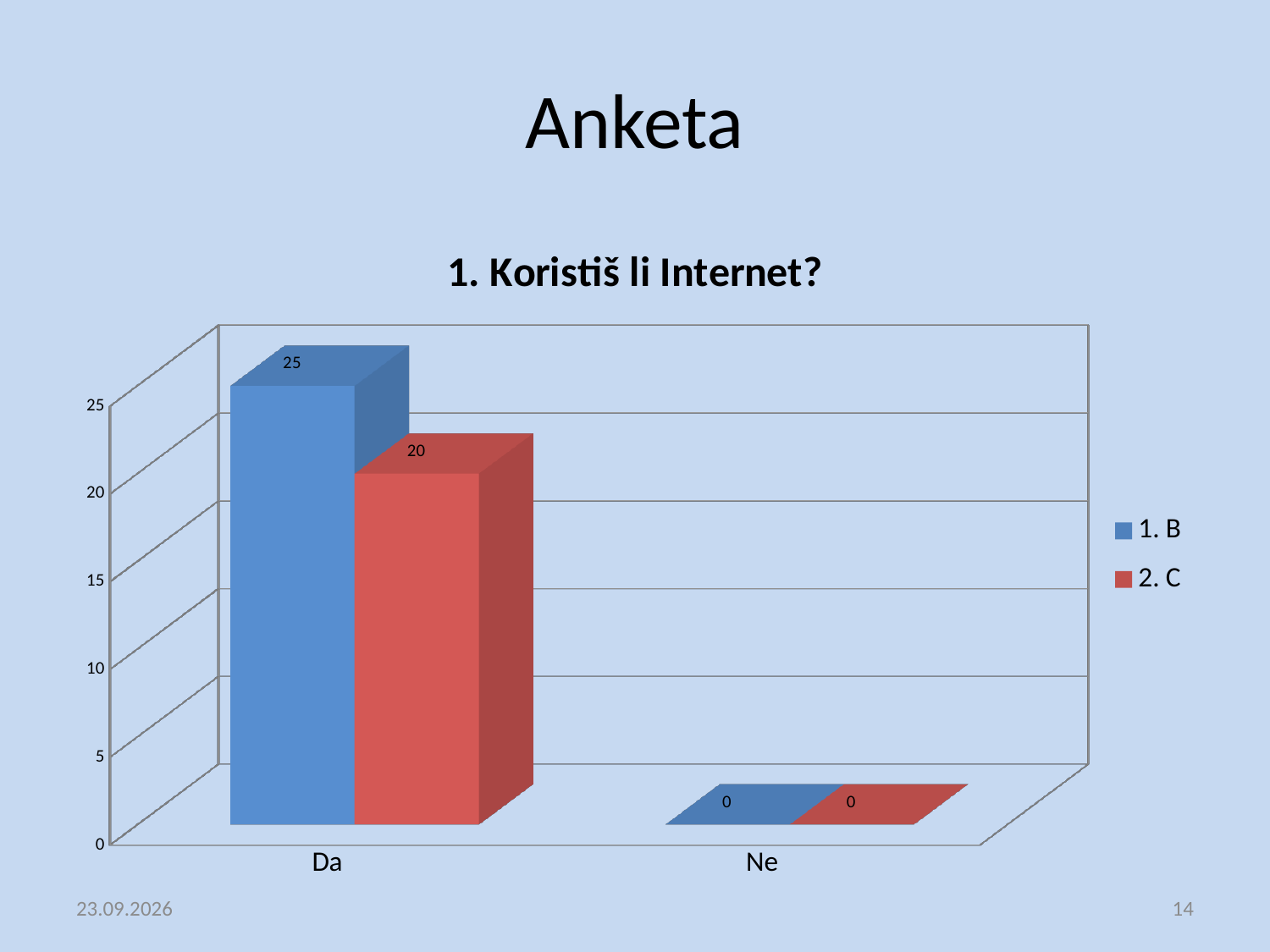
How many categories are shown on the x axis? 2 Which category has the highest value for series 1. B? Da What is the value for 1. B in the Da category? 25 What is the title of the chart? 1. Koristiš li Internet? What is the difference between the 1. B and 2. C values for Da? 5 What kind of chart is shown on the slide? Bar chart Which series has the higher value for Da, 1. B or 2. C? 1. B What is the value for 2. C in the Ne category? 0 What is the value for 1. B in the Ne category? 0 How many series does the legend list? 2 What is the value for 2. C in the Da category? 20 Which category has the lowest value for series 2. C? Ne